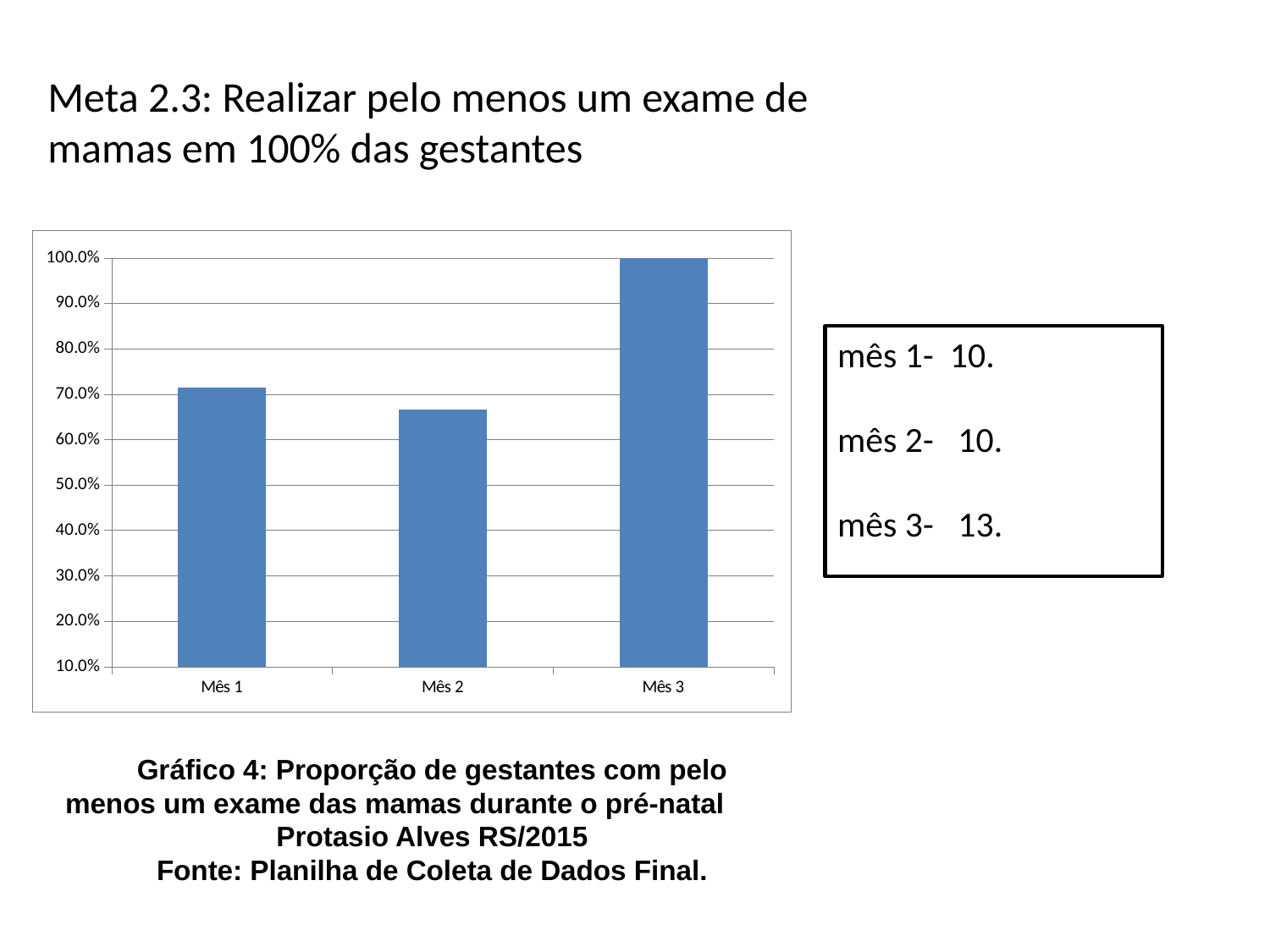
What is the value for Mês 3 in the chart? 100.0% What type of chart is shown on the slide? bar chart Is the value for Mês 2 greater or less than 70.0%? less Which month has the highest value in the chart? Mês 3 How many categories (months) are plotted in the chart? 3 Is the value for Mês 1 greater or less than 80.0%? less Which month has the lowest value in the chart? Mês 2 Does the value rise or fall from Mês 2 to Mês 3? rise What is the highest value shown on the vertical axis of the chart? 100.0% Which is larger, the value for Mês 1 or the value for Mês 2? Mês 1 Is the value for Mês 1 greater or less than 60.0%? greater What is the number of the graph given in the caption below the chart? Gráfico 4